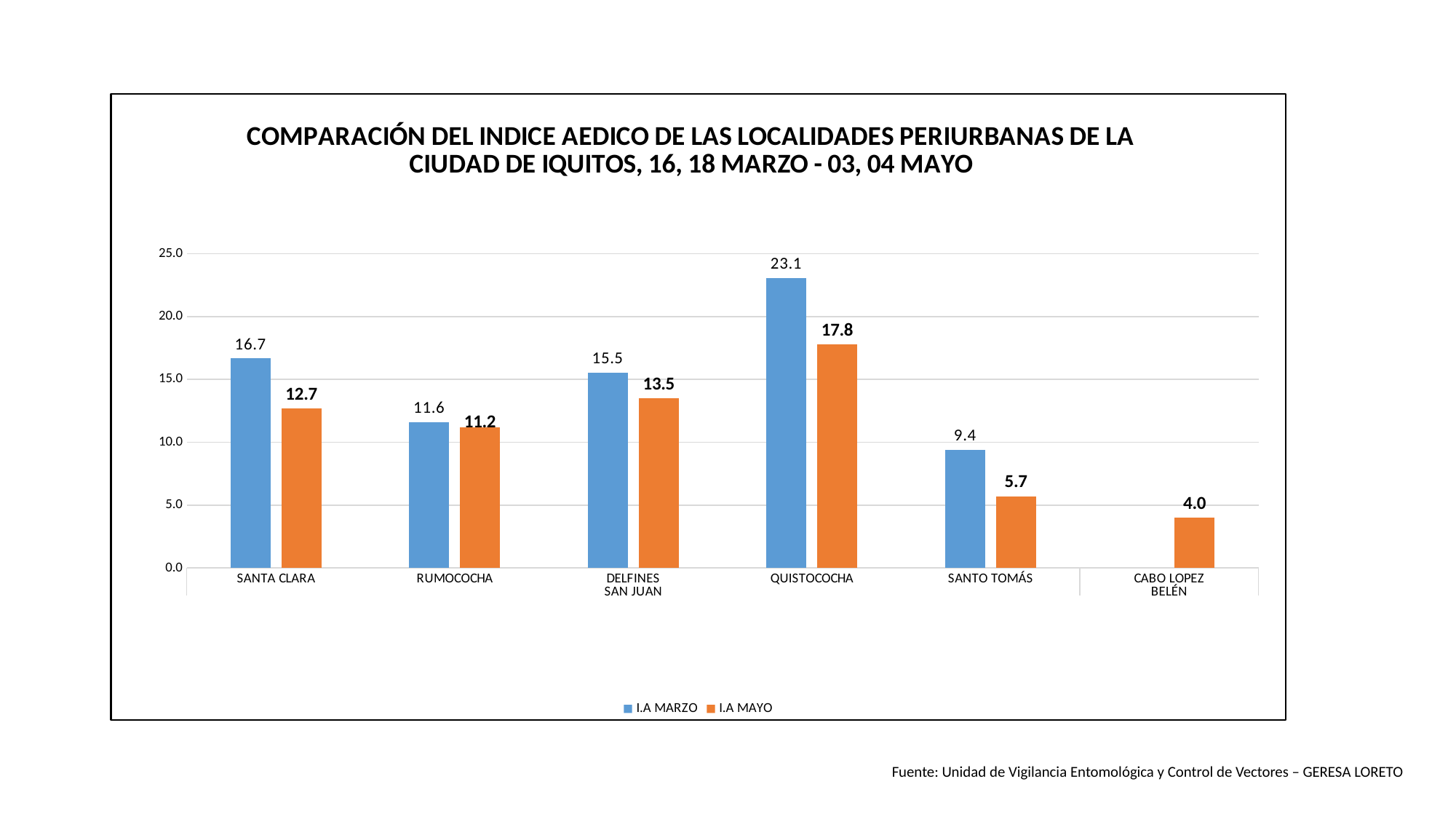
What is the I.A MARZO value for QUISTOCOCHA? 23.1 How many series does the legend list? 2 How many localities are shown on the x axis? 6 What is the difference between the I.A MARZO and I.A MAYO values for SANTA CLARA? 4.0 What is the I.A MAYO value for SANTO TOMÁS? 5.7 Which is larger for DELFINES SAN JUAN, the I.A MARZO value or the I.A MAYO value? I.A MARZO What is the I.A MAYO value for CABO LOPEZ BELÉN? 4.0 Is the I.A MAYO value for RUMOCOCHA greater or less than 15.0? less What kind of chart is shown on the slide? bar chart Which locality has the highest I.A MARZO value? QUISTOCOCHA Which colour represents the I.A MAYO series? orange Which locality has the lowest I.A MAYO value? CABO LOPEZ BELÉN